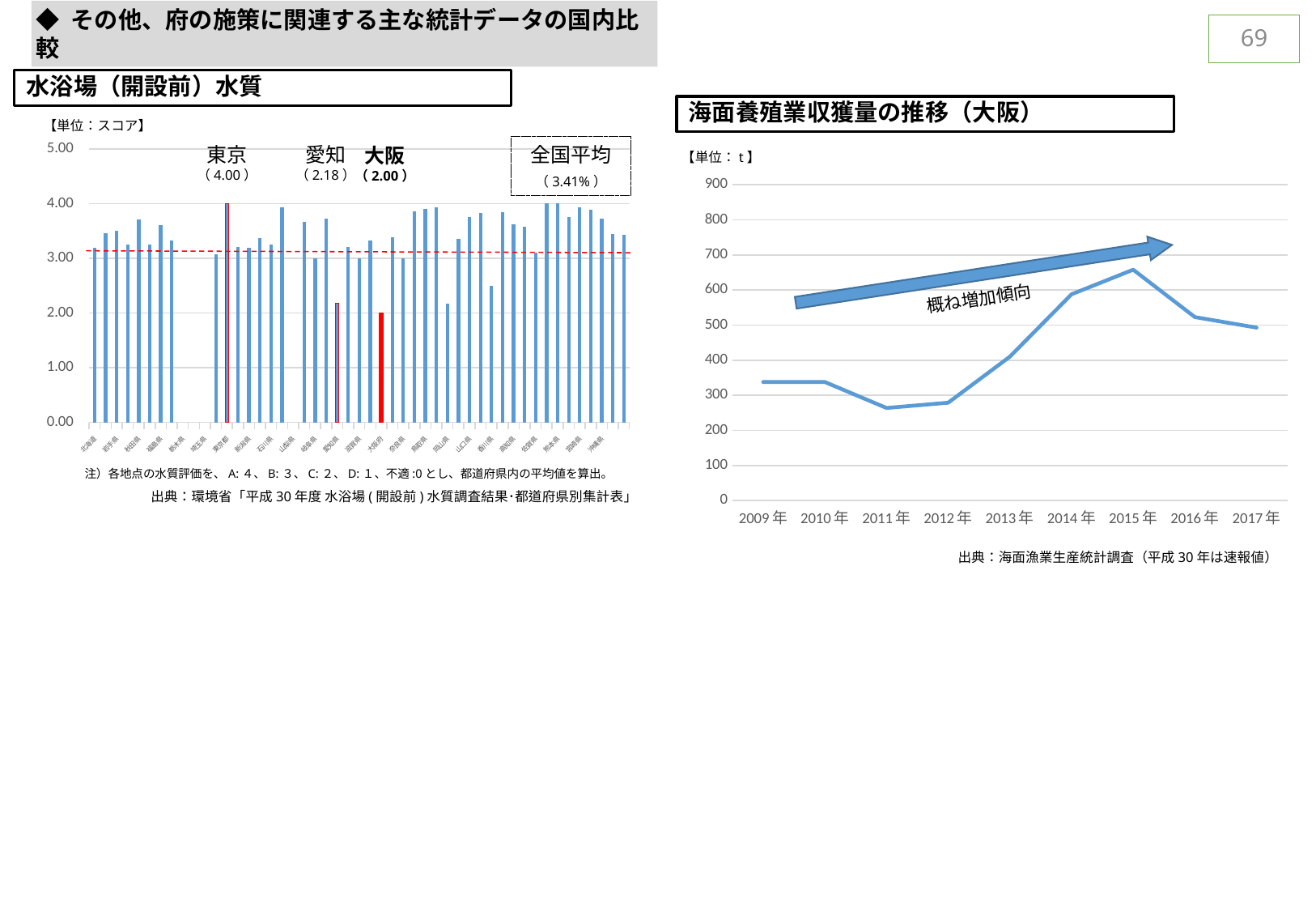
In the 水浴場（開設前）水質 chart, what is the score for 東京? 4.00 In the 水浴場（開設前）水質 chart, what is the score for 愛知? 2.18 In the 海面養殖業収獲量の推移（大阪） chart, is the value for 2015年 greater or less than 600? greater What kind of chart is the 海面養殖業収獲量の推移（大阪） chart on the right? line chart In the 海面養殖業収獲量の推移（大阪） chart, how many years are plotted on the x axis? 9 In the 水浴場（開設前）水質 chart, what is the 全国平均 value shown in the box? 3.41% In the 海面養殖業収獲量の推移（大阪） chart, which year has the highest value? 2015年 In the 水浴場（開設前）水質 chart, what is the score for 大阪? 2.00 What kind of chart is the 水浴場（開設前）水質 chart on the left? bar chart In the 水浴場（開設前）水質 chart, what is the difference between the scores for 東京 and 大阪? 2.00 In the 海面養殖業収獲量の推移（大阪） chart, which year has the lowest value? 2011年 In the 水浴場（開設前）水質 chart, which has the higher score, 愛知 or 大阪? 愛知